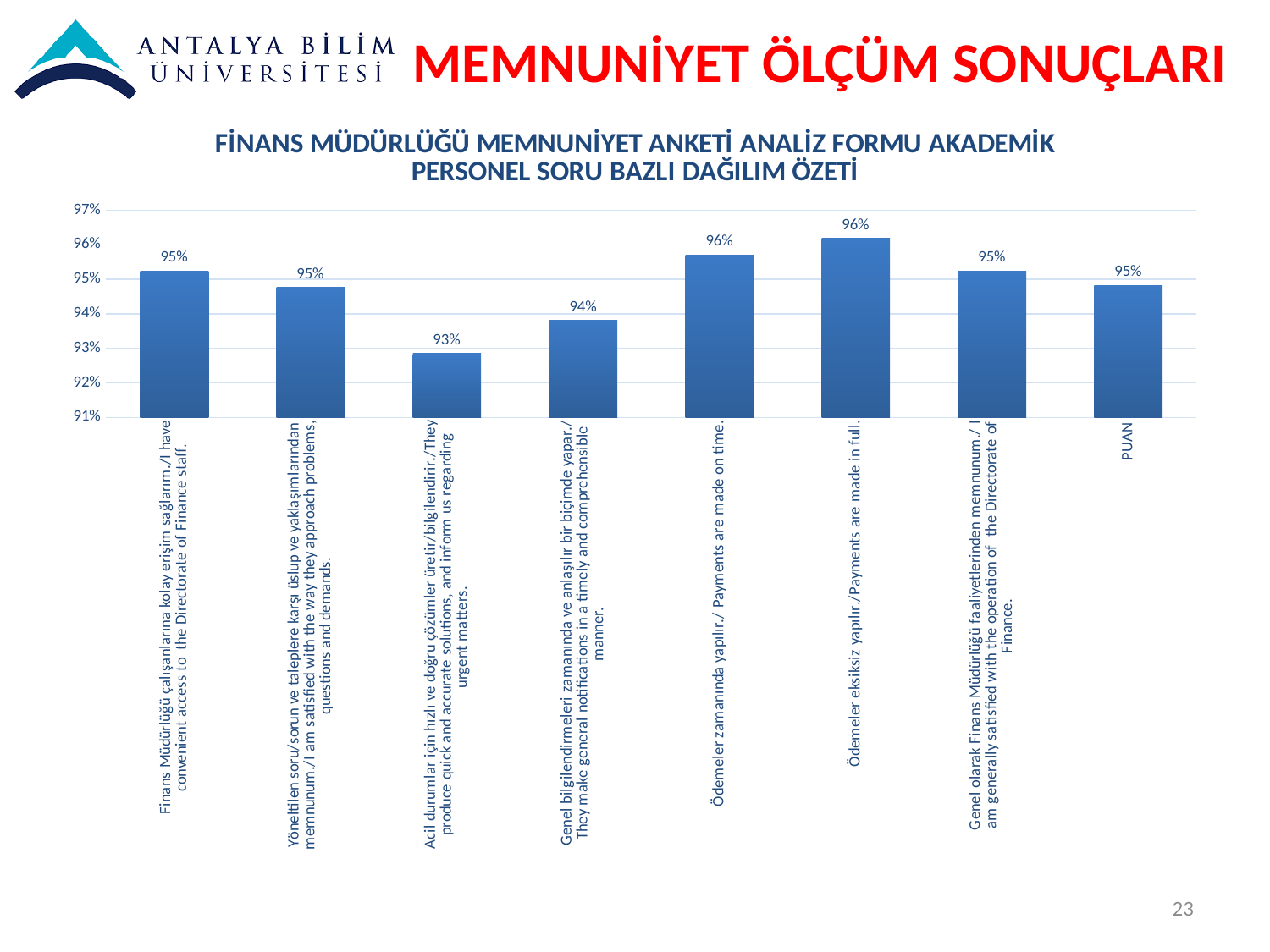
What is the value for PUAN? 95% Is the value for "Acil durumlar için hızlı ve doğru çözümler üretir/bilgilendirir." greater or less than 94%? less Which category has the lowest value? Acil durumlar için hızlı ve doğru çözümler üretir/bilgilendirir./They produce quick and accurate solutions, and inform us regarding urgent matters. What is the value for "Ödemeler zamanında yapılır./ Payments are made on time."? 96% What is the title of the chart? FİNANS MÜDÜRLÜĞÜ MEMNUNİYET ANKETİ ANALİZ FORMU AKADEMİK PERSONEL SORU BAZLI DAĞILIM ÖZETİ What is the value for "Genel bilgilendirmeleri zamanında ve anlaşılır bir biçimde yapar./ They make general notifications in a timely and comprehensible manner."? 94% What type of chart is shown on the slide? bar chart What is the value for "Acil durumlar için hızlı ve doğru çözümler üretir/bilgilendirir./They produce quick and accurate solutions, and inform us regarding urgent matters."? 93% Is the value for PUAN greater or less than 94%? greater How many bars (categories) are plotted in the chart? 8 Which is larger: the value for "Ödemeler eksiksiz yapılır./Payments are made in full." or the value for "Genel bilgilendirmeleri zamanında ve anlaşılır bir biçimde yapar."? Ödemeler eksiksiz yapılır./Payments are made in full. What is the difference between the value for "Ödemeler eksiksiz yapılır./Payments are made in full." and the value for "Acil durumlar için hızlı ve doğru çözümler üretir/bilgilendirir."? 3 percentage points